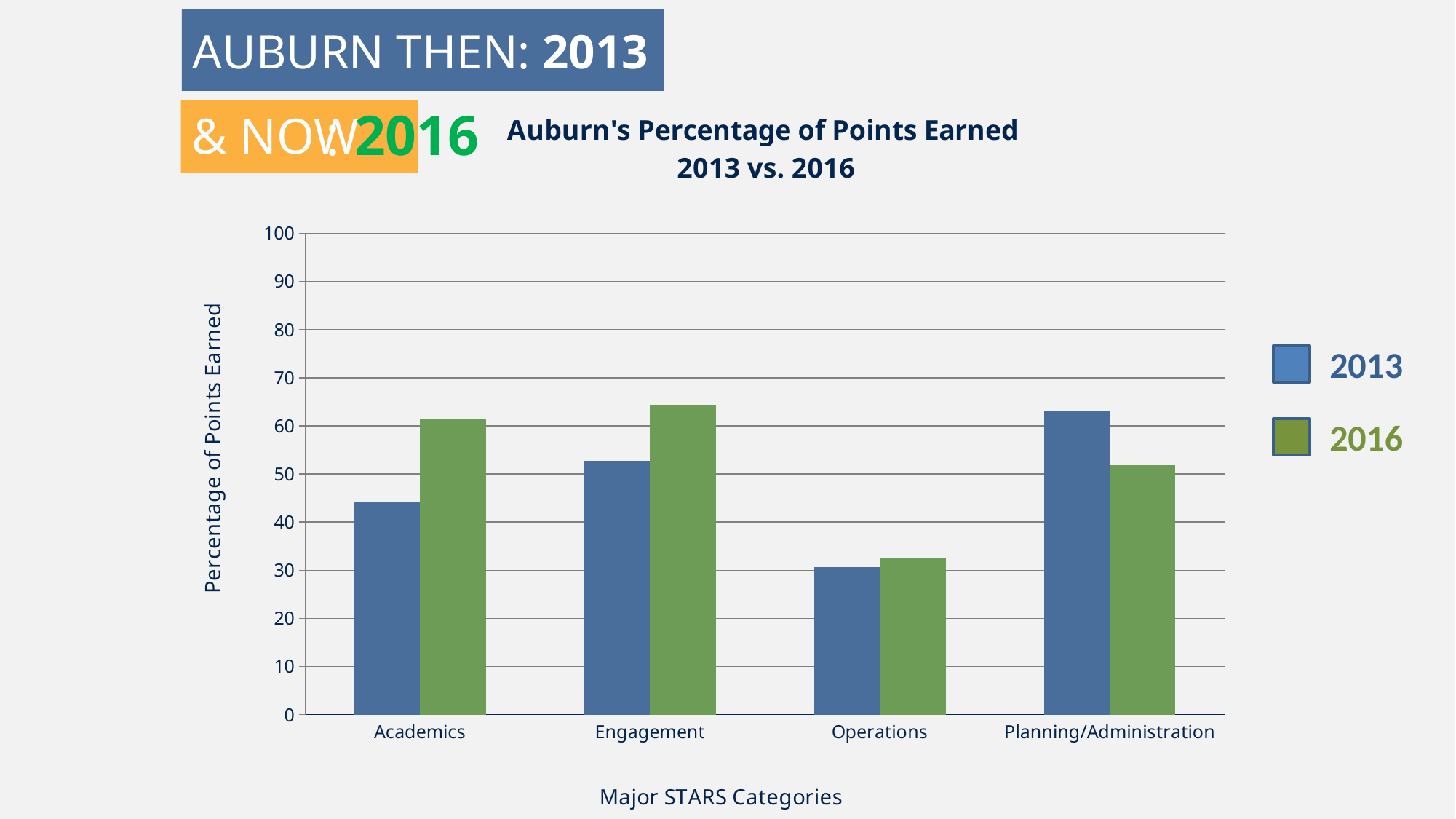
Is the value for Operations in 2016 greater or less than 40? less For Academics, which series has the larger value, 2013 or 2016? 2016 For Planning/Administration, which series has the larger value, 2013 or 2016? 2013 Which category has the lowest value for the 2016 series? Operations How many series does the chart's legend list? 2 What is the title of the chart? Auburn's Percentage of Points Earned 2013 vs. 2016 Is the value for Academics in 2013 greater or less than 40? greater Which category has the highest value for the 2013 series? Planning/Administration How many categories are shown on the x axis of the chart? 4 Which category has the lowest value for the 2013 series? Operations What kind of chart is shown on the slide? bar chart Is the value for Engagement in 2016 greater or less than 60? greater